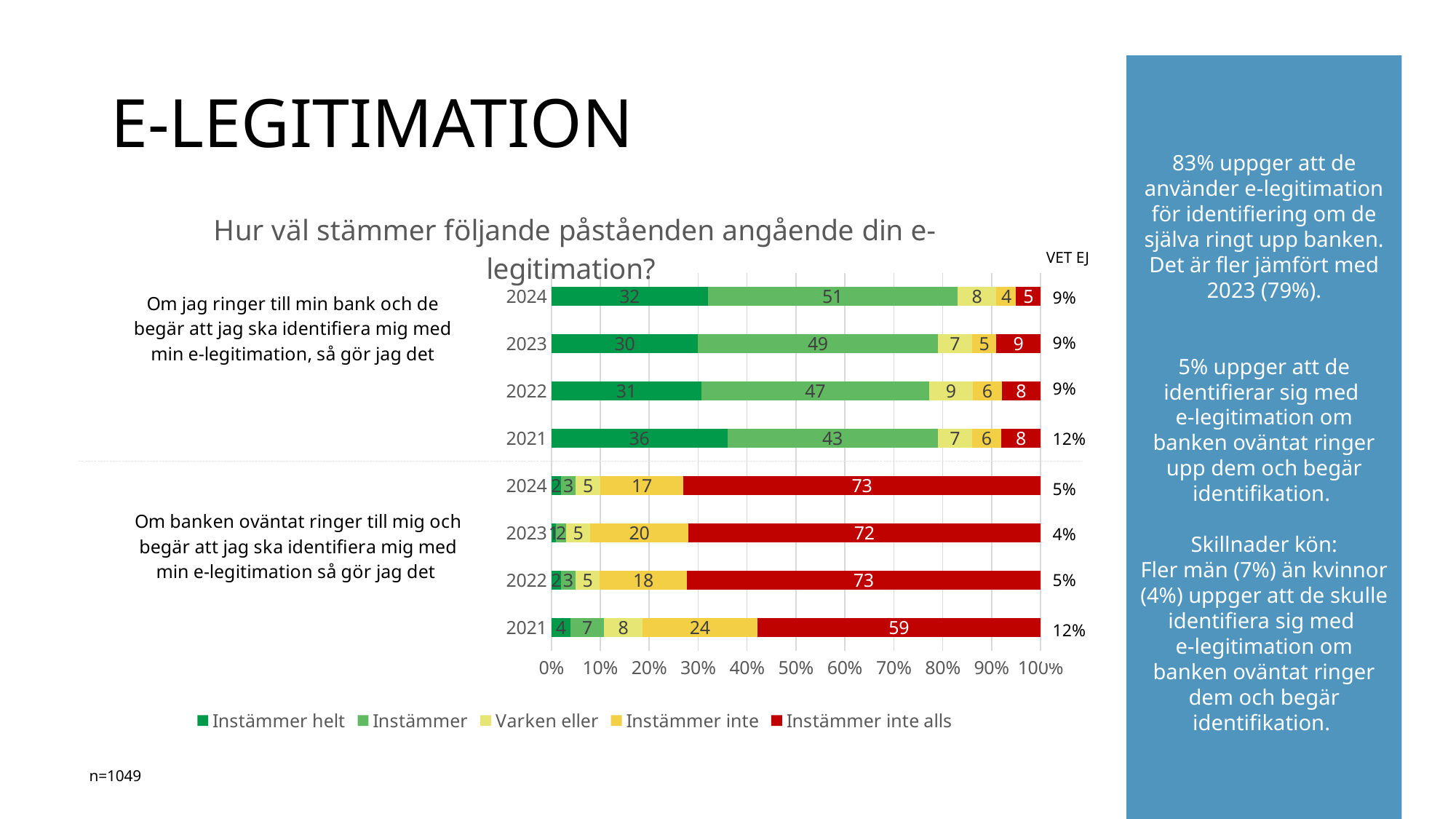
For the statement 'Om jag ringer till min bank och de begär att jag ska identifiera mig med min e-legitimation, så gör jag det', what is the 'Instämmer helt' value for 2024? 32 What kind of chart is shown on the slide? Stacked bar chart How many bars are plotted in the chart in total? 8 For the statement 'Om jag ringer till min bank...', what is the difference between the 'Instämmer' values for 2024 and 2023? 2 For the statement 'Om jag ringer till min bank...', does the 'Instämmer' value rise or fall from 2021 to 2024? Rise What is the total of the stacked bar for 2024 under the statement 'Om jag ringer till min bank...'? 100 What is the 'VET EJ' value shown for 2021 under the statement 'Om banken oväntat ringer till mig...'? 12% For the statement 'Om banken oväntat ringer till mig och begär att jag ska identifiera mig med min e-legitimation så gör jag det', what is the 'Instämmer inte alls' value for 2021? 59 For the statement 'Om jag ringer till min bank...', which year has the larger 'Instämmer inte alls' value, 2023 or 2024? 2023 For the statement 'Om jag ringer till min bank...', which year has the highest 'Instämmer helt' value? 2021 For the statement 'Om banken oväntat ringer till mig...', which year has the lowest 'Instämmer inte alls' value? 2021 How many series does the chart legend list? 5